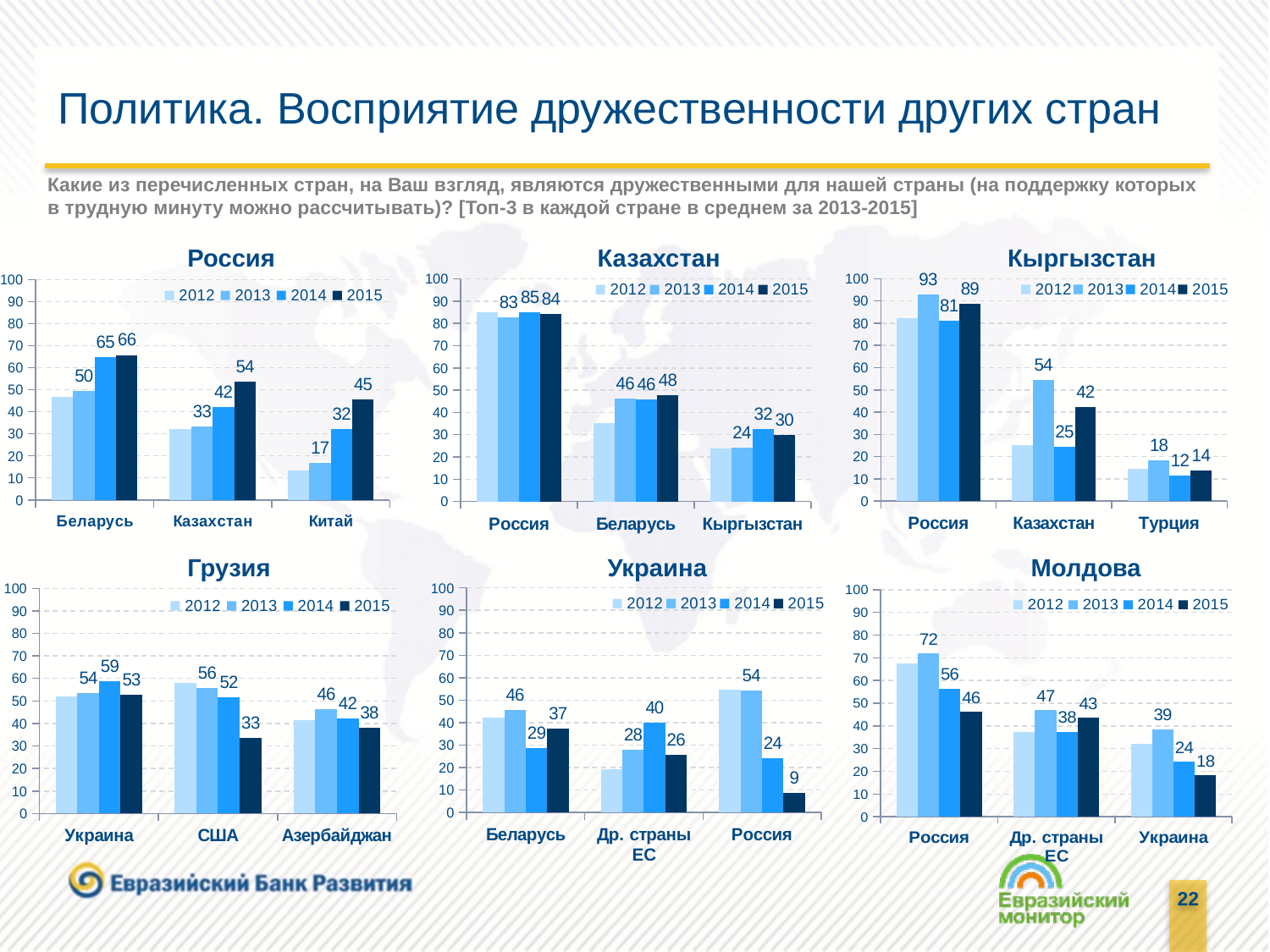
How many categories are shown on the x axis of the chart titled "Украина"? 3 How many charts are shown on the slide? 6 In the chart titled "Молдова", which is larger: the 2015 value for Россия or the 2015 value for Др. страны ЕС? Россия In the chart titled "Кыргызстан", which category has the lowest value in 2015? Турция In the chart titled "Россия", do the values for Китай rise or fall from 2013 to 2015? rise In the chart titled "Украина", what is the difference between the 2013 and 2015 values for Россия? 45 In the chart titled "Россия", what is the value for Беларусь in 2015? 66 In the chart titled "Грузия", is the 2012 value for США greater or less than 50? greater How many series does the legend of the chart titled "Молдова" list? 4 In the chart titled "Кыргызстан", which category has the highest value in 2013? Россия What kind of chart is the chart titled "Грузия"? bar chart In the chart titled "Казахстан", what is the value for Кыргызстан in 2014? 32